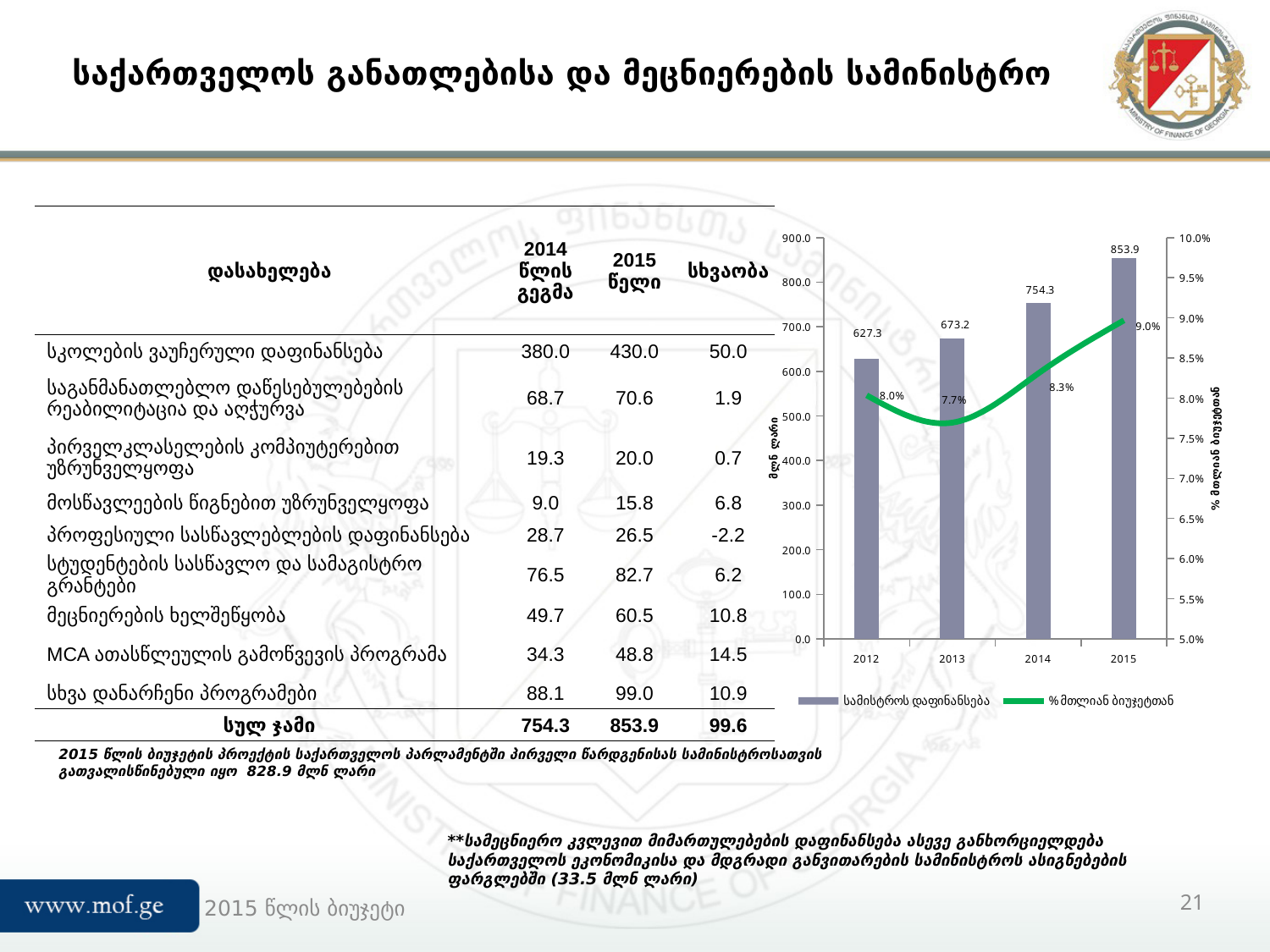
Do the bar values rise or fall from 2012 to 2015? rise Which year has the lowest percentage on the line? 2013 What is the value of the bar for 2015 in the chart? 853.9 What is the value of the bar for 2012 in the chart? 627.3 What percentage does the line show for 2013? 7.7% What is the difference between the bar values for 2015 and 2014? 99.6 Which year has the highest bar value in the chart? 2015 Is the bar value for 2013 greater or less than 700.0? less What percentage does the line show for 2015? 9.0% How many series does the chart legend list? 2 How many years are shown on the x axis of the chart? 4 Which is larger, the bar value for 2013 or for 2014? 2014